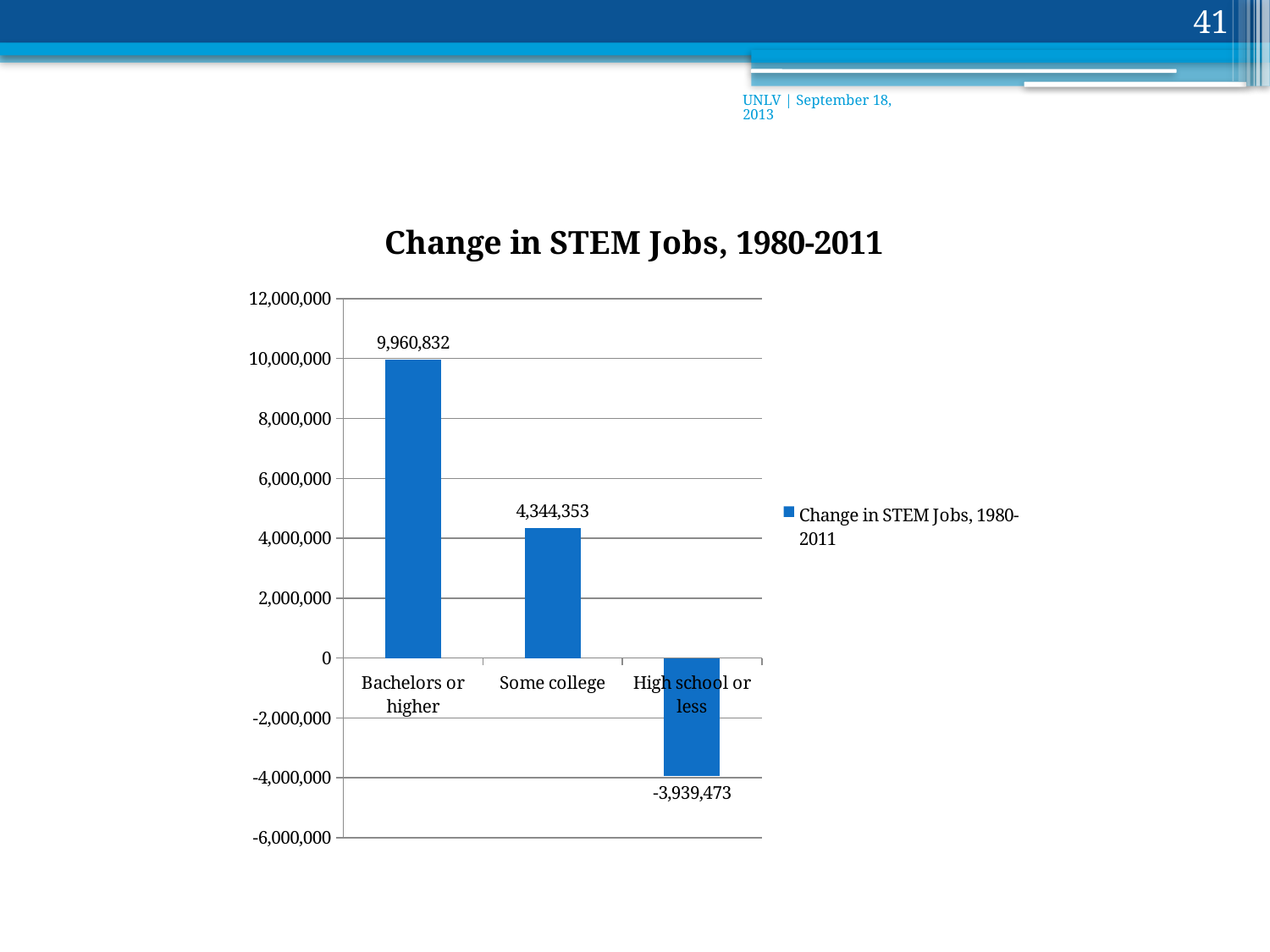
What kind of chart is shown on the slide? bar chart How many categories are shown on the x axis? 3 What is the difference between the change in STEM jobs for Bachelors or higher and Some college? 5,616,479 Is the value for Some college greater or less than 6,000,000? less How many series does the legend list? 1 Which is larger, the change in STEM jobs for Some college or for High school or less? Some college Which category has the highest change in STEM jobs? Bachelors or higher What is the change in STEM jobs for Some college? 4,344,353 What is the change in STEM jobs for Bachelors or higher? 9,960,832 Which category has the lowest change in STEM jobs? High school or less What is the change in STEM jobs for High school or less? -3,939,473 What is the title of the chart? Change in STEM Jobs, 1980-2011